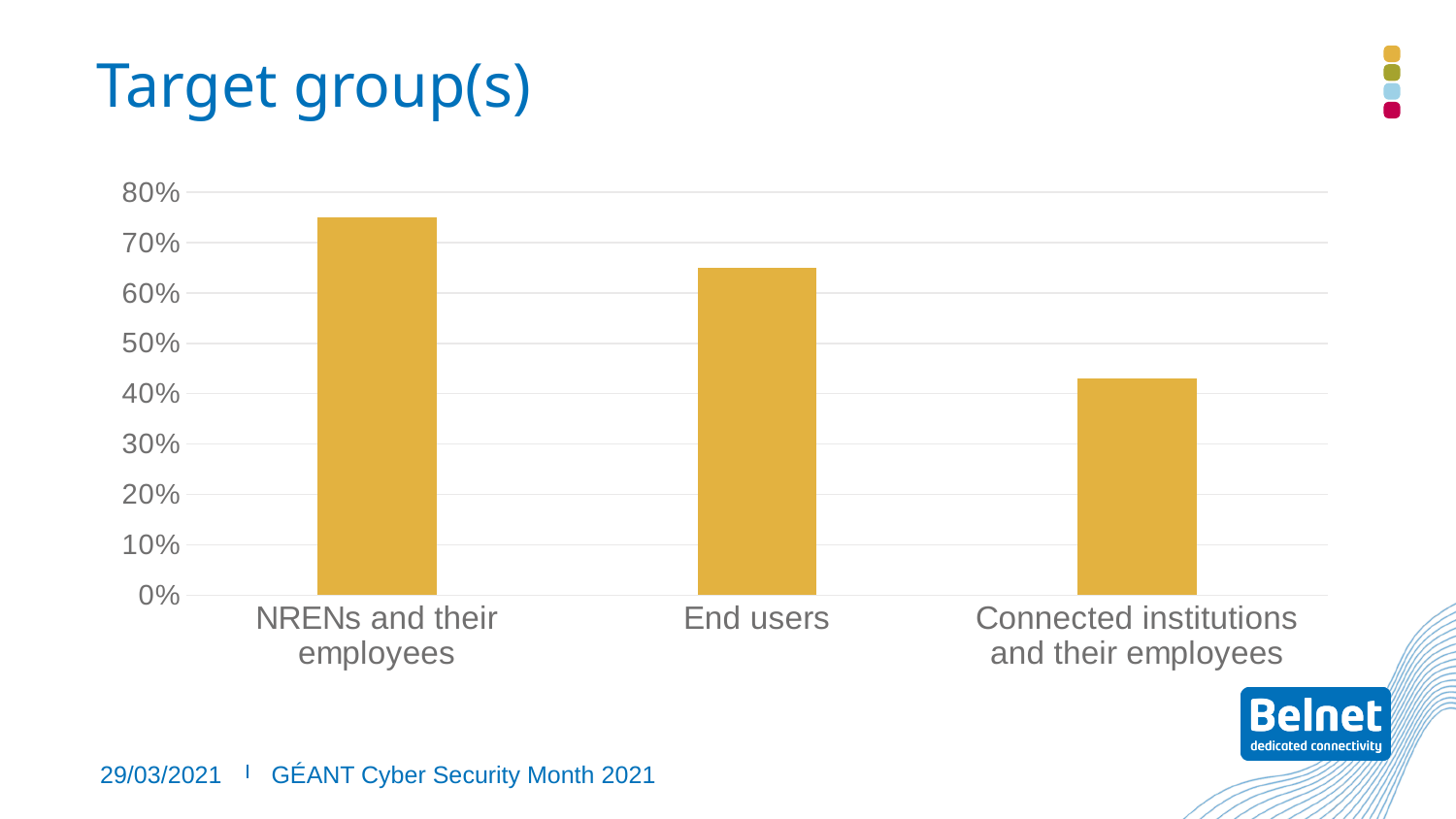
Which category has the highest bar in the chart? NRENs and their employees Is the value for NRENs and their employees greater or less than 70%? greater Which is larger, the value for End users or the value for Connected institutions and their employees? End users How many categories are shown on the x axis of the chart? 3 Which category has the lowest bar in the chart? Connected institutions and their employees Is the value for Connected institutions and their employees greater or less than 50%? less What is the title of the slide containing the chart? Target group(s) Is the value for Connected institutions and their employees greater or less than 40%? greater Which is larger, the value for NRENs and their employees or the value for End users? NRENs and their employees What kind of chart is shown on the slide? bar chart Do the bar values rise or fall from left to right across the x axis? fall